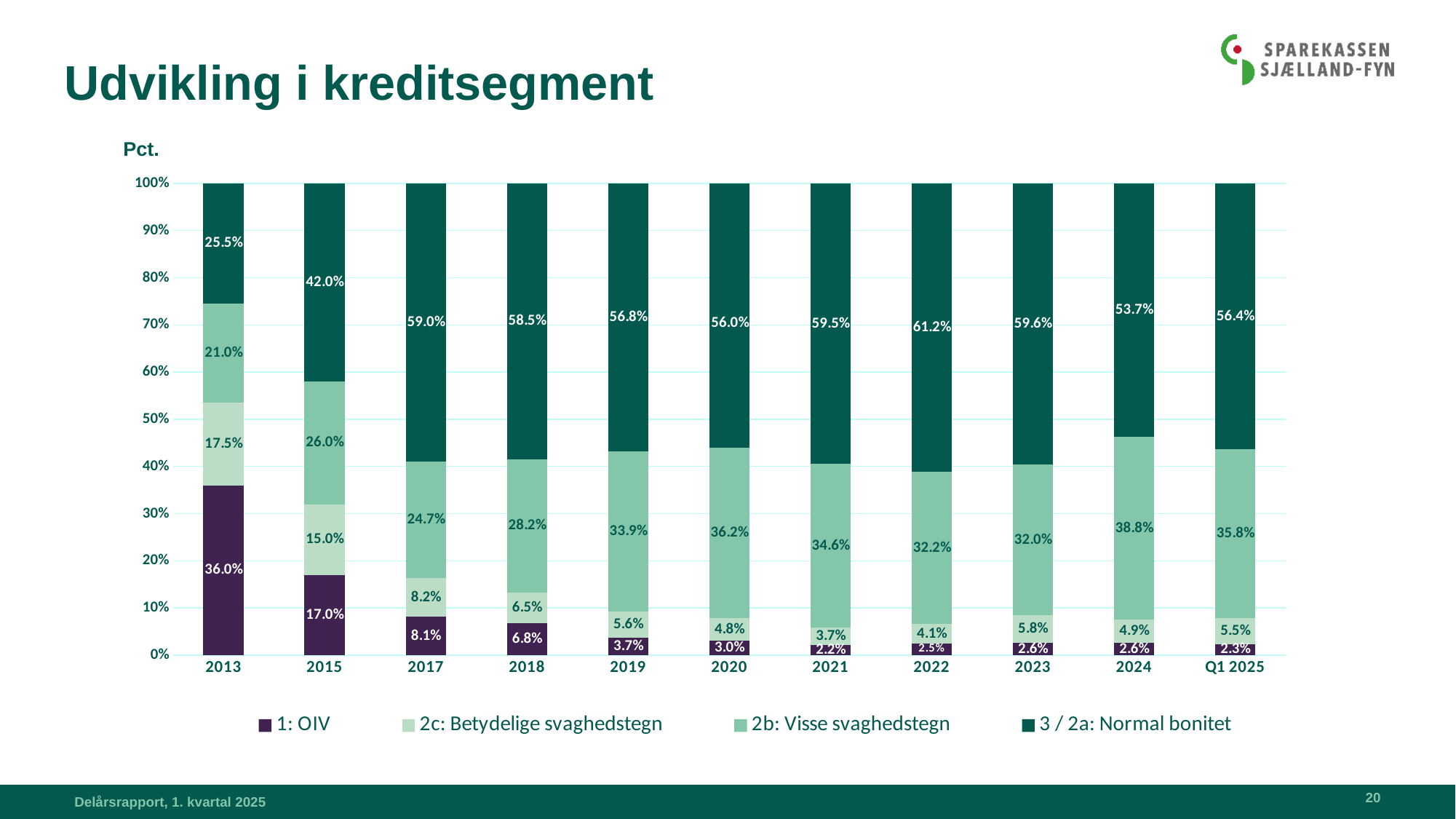
What is the value for 2c: Betydelige svaghedstegn in 2015? 15.0% Does the 1: OIV share rise or fall from 2013 to Q1 2025? Fall What is the value for 1: OIV in 2013? 36.0% In which year is the 1: OIV share lowest? 2021 Which is larger: the 2b: Visse svaghedstegn share in 2024 or in 2023? 2024 In which year is the 3 / 2a: Normal bonitet share highest? 2022 What kind of chart is shown on the slide? Stacked bar chart What is the value for 2b: Visse svaghedstegn in 2020? 36.2% What is the difference between the 3 / 2a: Normal bonitet share in 2022 and in 2013? 35.7 percentage points How many series does the legend list? 4 How many periods are shown on the x axis? 11 What is the value for 3 / 2a: Normal bonitet in Q1 2025? 56.4%